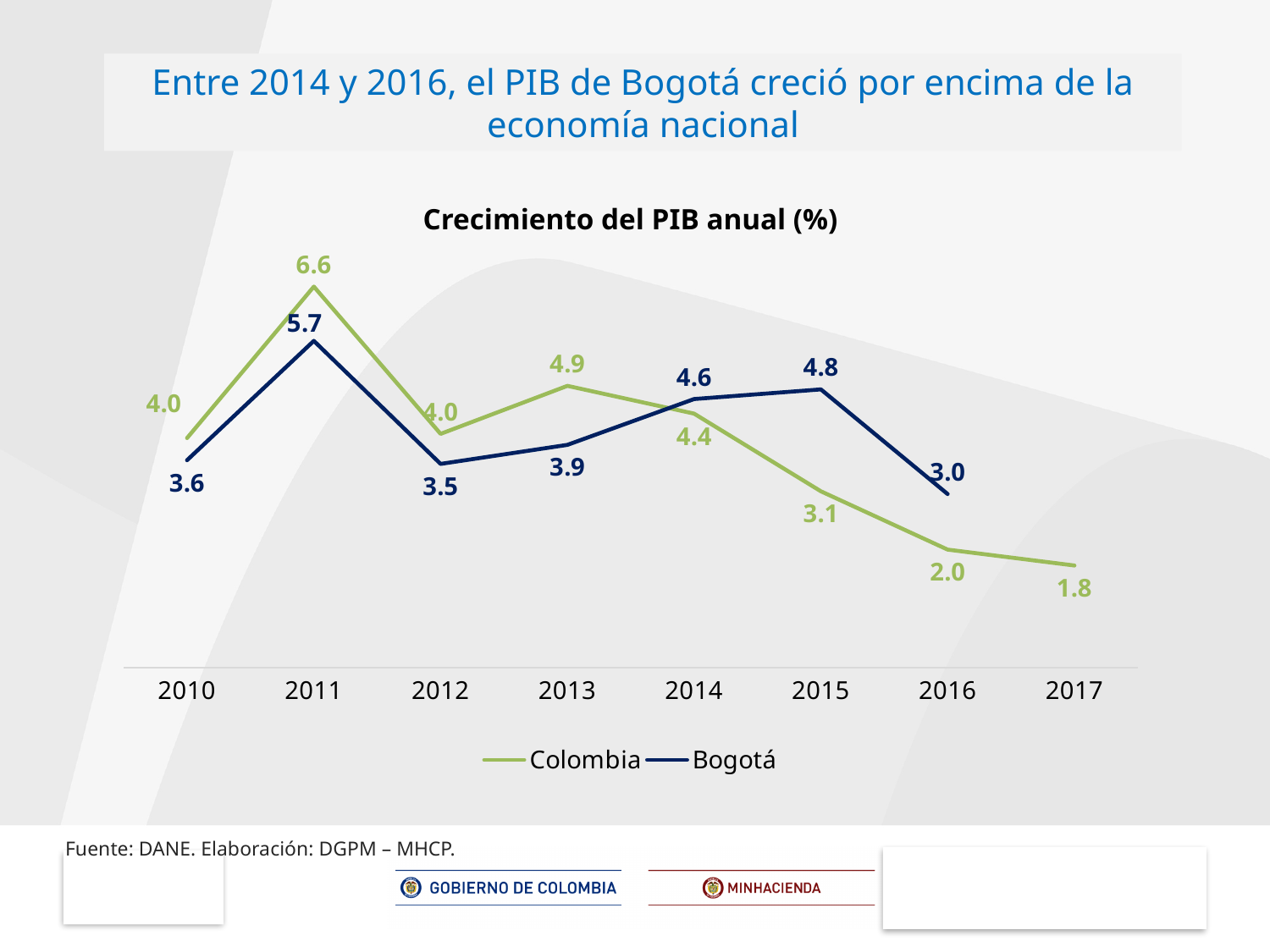
In which year is the Colombia series highest? 2011 Which series has the larger value in 2015, Colombia or Bogotá? Bogotá What is the difference between the Colombia and Bogotá values in 2011? 0.9 What is the Bogotá value for 2012? 3.5 What kind of chart is shown? Line chart What is the Colombia value for 2017? 1.8 What is the title of the chart? Crecimiento del PIB anual (%) In which year is the Bogotá series lowest? 2016 How many years are shown on the x axis? 8 What is the Colombia value for 2011? 6.6 How many series does the legend list? 2 What is the Bogotá value for 2015? 4.8